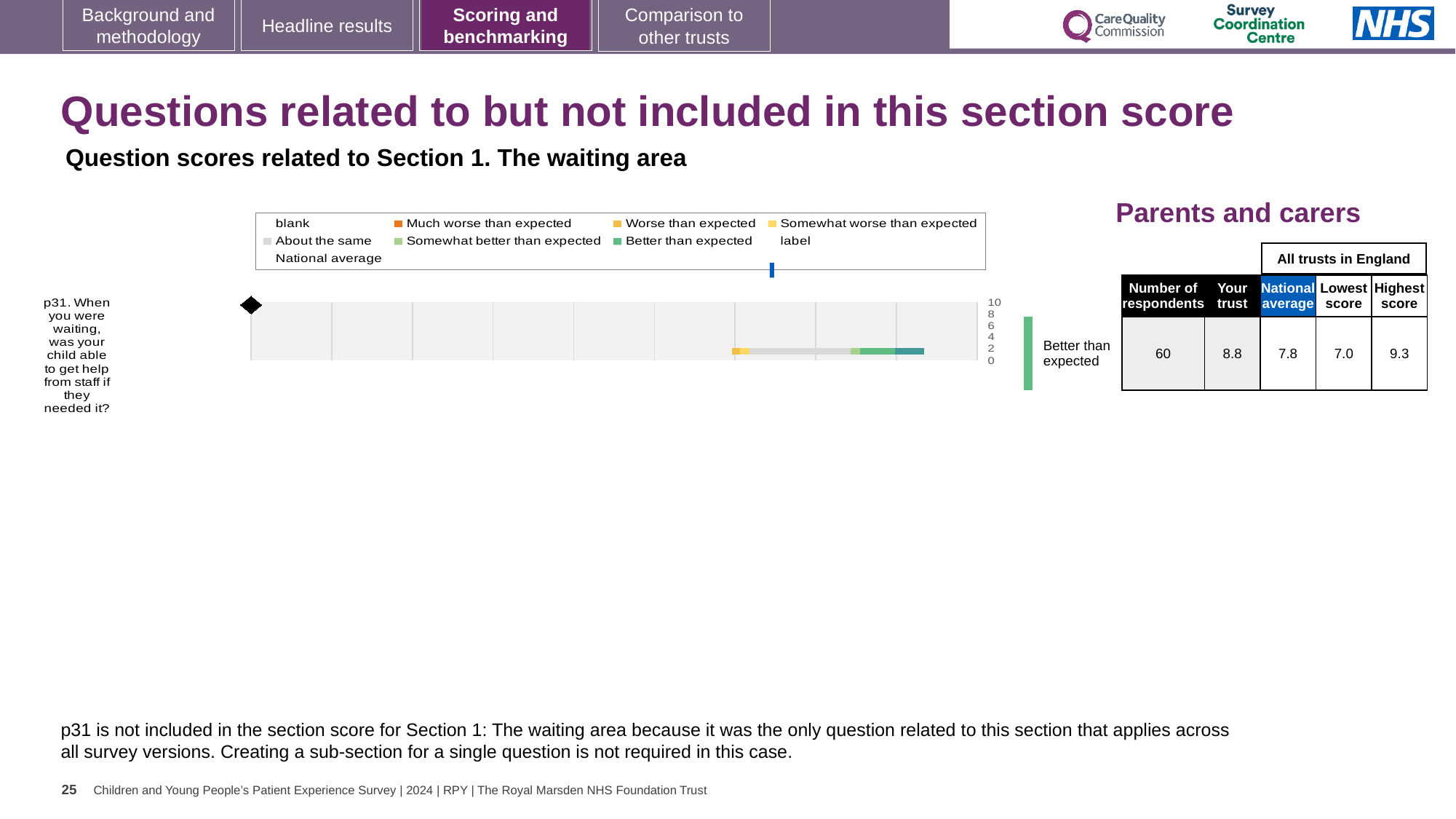
What benchmark label is shown to the right of the chart for p31? Better than expected In the table next to the chart, what is the National average score for p31? 7.8 What kind of chart is shown on the slide? bar chart What is the difference between the Highest score and the Lowest score for p31? 2.3 Is the Your trust score for p31 higher or lower than the National average? higher What is the difference between the Your trust score and the National average for p31? 1.0 Which question is plotted in the chart? p31. When you were waiting, was your child able to get help from staff if they needed it? In the table next to the chart, what is the score for Your trust for p31? 8.8 In the table next to the chart, how many respondents answered p31? 60 How many questions (categories) are plotted in the chart? 1 In the table next to the chart, what is the Lowest score for p31? 7.0 In the table next to the chart, what is the Highest score for p31? 9.3